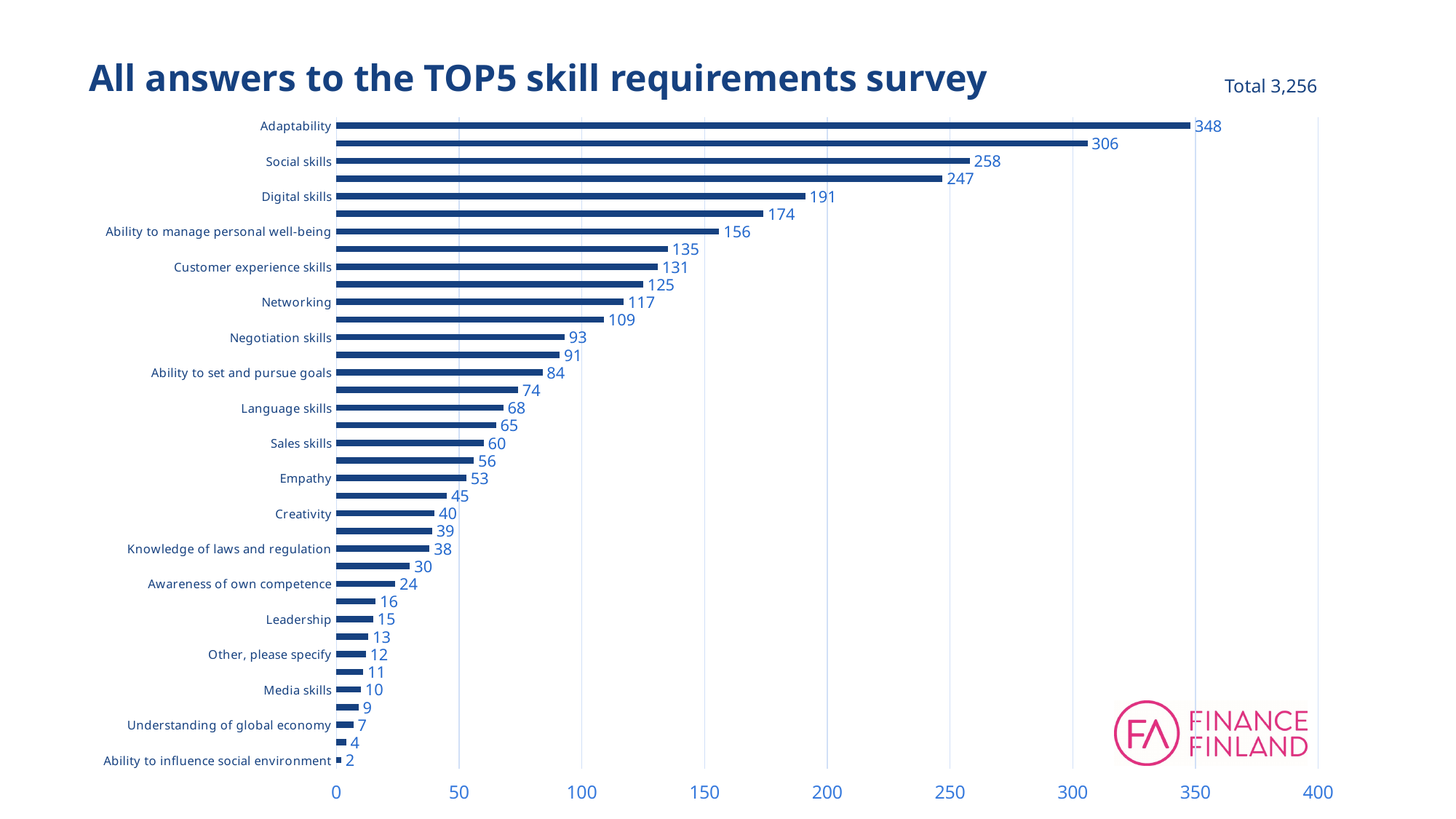
Do the bar values rise or fall going from the top of the chart to the bottom? fall What is the value for Adaptability? 348 What kind of chart is shown on the slide? bar chart Which labelled category has the highest value? Adaptability What is the value for Digital skills? 191 What is the difference between the values for Adaptability and Social skills? 90 Which is larger, the value for Networking or the value for Negotiation skills? Networking What total number of answers is stated on the slide? Total 3,256 Which labelled category has the lowest value? Ability to influence social environment What is the value for Social skills? 258 What is the value for Leadership? 15 What is the value for Customer experience skills? 131